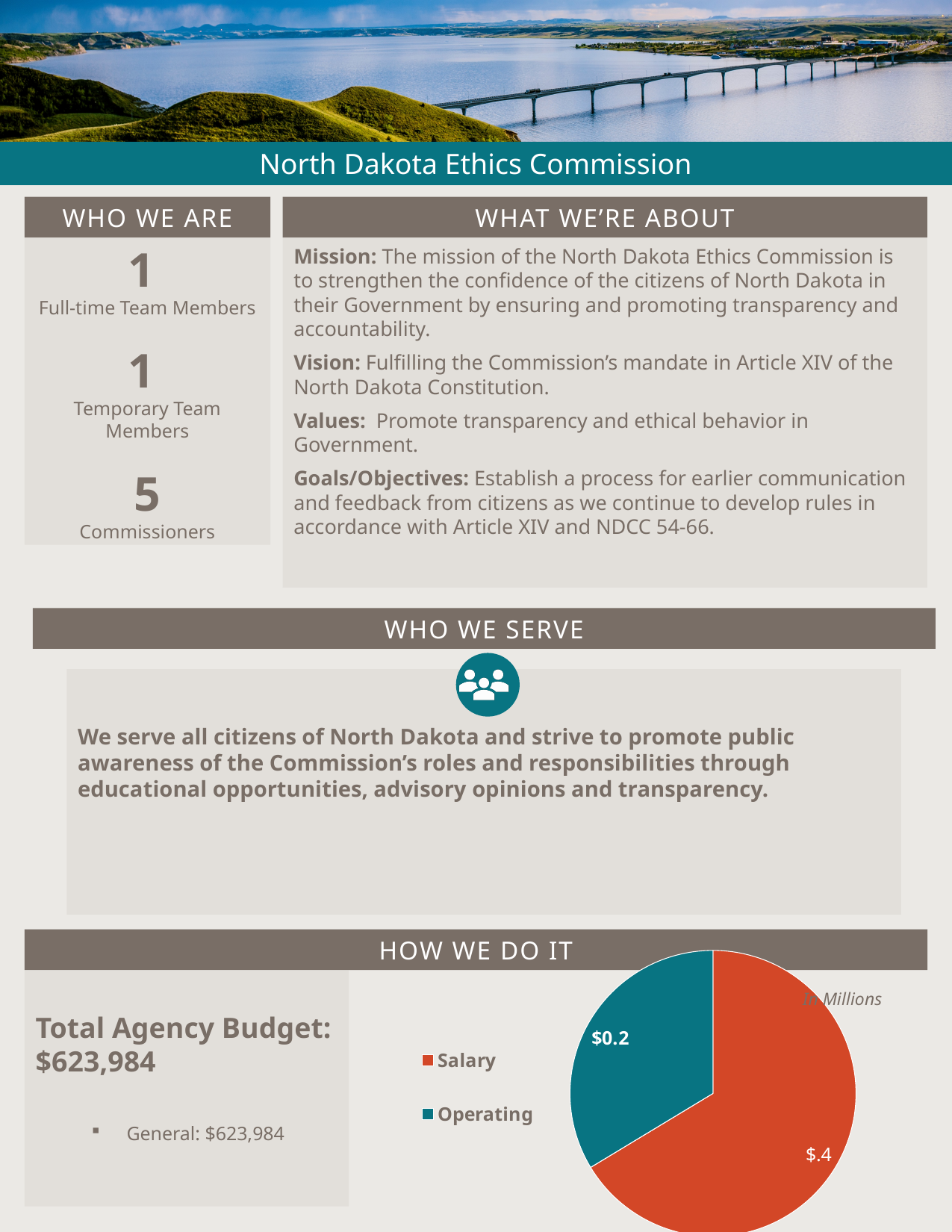
What are the two categories listed in the pie chart's legend? Salary and Operating What kind of chart is shown in the "How We Do It" section? pie chart What colour is the Operating slice in the pie chart? teal In the pie chart, which is larger, Salary or Operating? Salary Which slice of the pie chart is the smallest? Operating How many entries does the pie chart's legend list? 2 How many slices does the pie chart have? 2 What value is labelled on the Operating slice of the pie chart? $0.2 What unit note appears next to the pie chart? In Millions Which slice of the pie chart is the largest? Salary